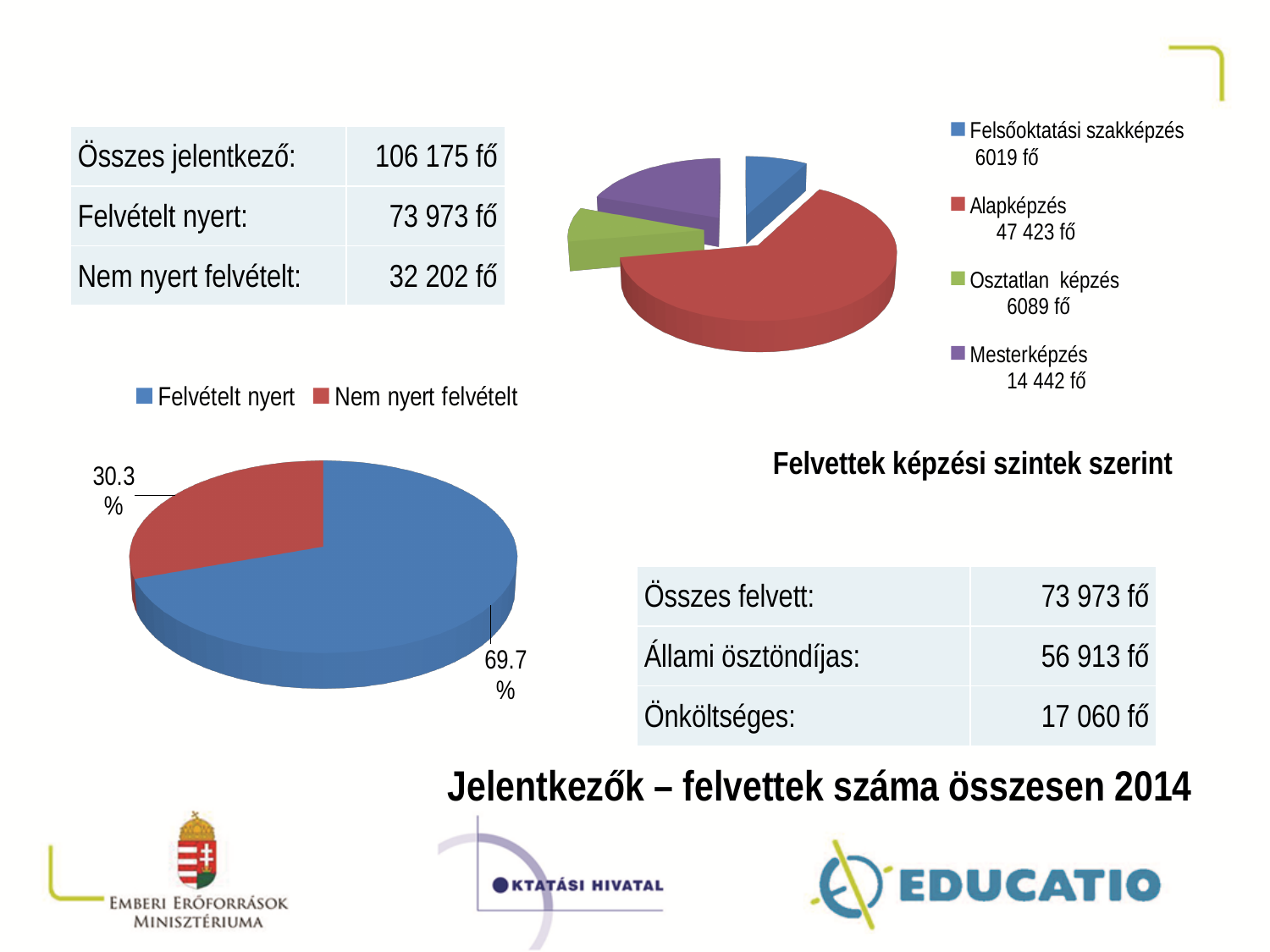
What kind of chart is the chart titled 'Felvettek képzési szintek szerint'? Pie chart In the chart titled 'Felvettek képzési szintek szerint', which is larger: Mesterképzés or Osztatlan képzés? Mesterképzés In the chart titled 'Felvettek képzési szintek szerint', what is the difference between Alapképzés and Mesterképzés? 32 981 fő In the chart titled 'Felvettek képzési szintek szerint', what is the value for Felsőoktatási szakképzés? 6019 fő How many categories does the chart titled 'Felvettek képzési szintek szerint' show? 4 In the chart titled 'Felvettek képzési szintek szerint', what is the value for Mesterképzés? 14 442 fő In the pie chart at the bottom left of the slide, what share does 'Nem nyert felvételt' have? 30.3% In the chart titled 'Felvettek képzési szintek szerint', what is the value for Alapképzés? 47 423 fő In the pie chart at the bottom left of the slide, what is the difference in percentage points between 'Felvételt nyert' and 'Nem nyert felvételt'? 39.4 In the chart titled 'Felvettek képzési szintek szerint', which category has the highest value? Alapképzés How many entries does the legend of the pie chart at the bottom left of the slide list? 2 In the pie chart at the bottom left of the slide, what share does 'Felvételt nyert' have? 69.7%